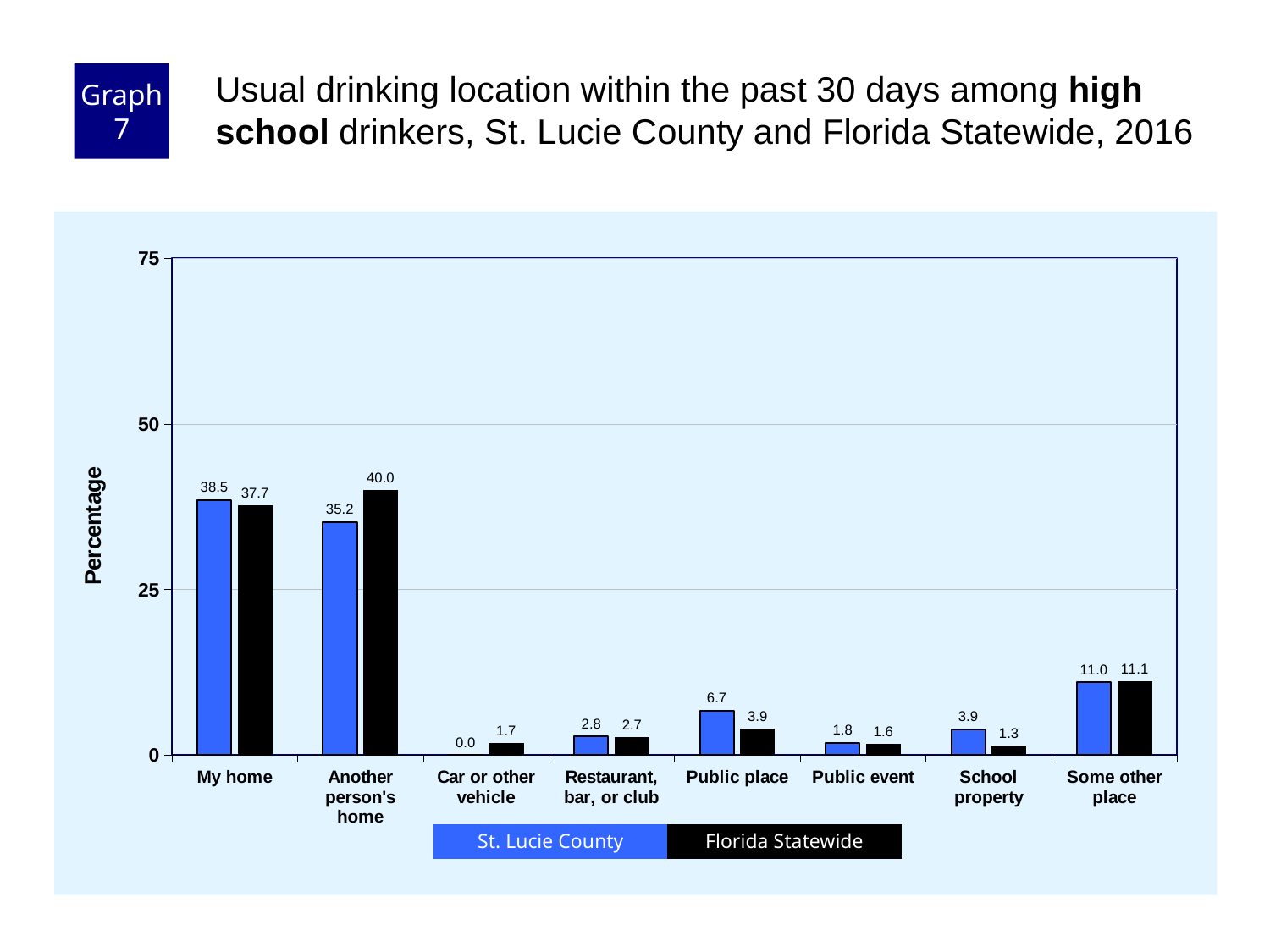
Which category has the highest Florida Statewide value? Another person's home How many series does the legend list? 2 Which is larger for Another person's home: St. Lucie County or Florida Statewide? Florida Statewide What is the St. Lucie County value for My home? 38.5 What is the Florida Statewide value for Another person's home? 40.0 What is the Florida Statewide value for School property? 1.3 Is the St. Lucie County value for My home greater or less than 25? greater What is the St. Lucie County value for Car or other vehicle? 0.0 What is the difference between the St. Lucie County and Florida Statewide values for Public place? 2.8 Which category has the lowest St. Lucie County value? Car or other vehicle What kind of chart is shown on the slide? Bar chart How many categories are shown on the x axis? 8